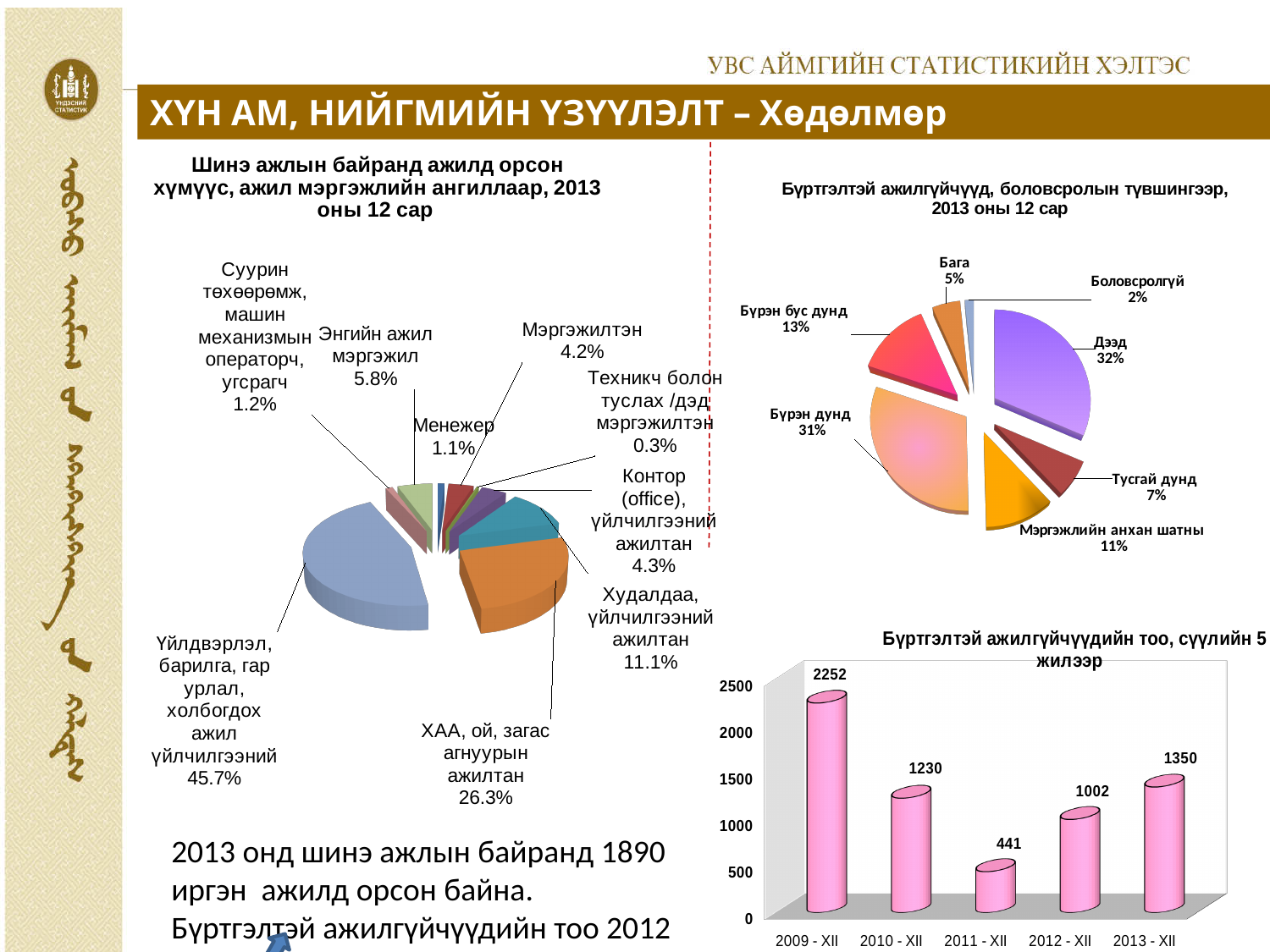
In the bar chart 'Бүртгэлтэй ажилгүйчүүдийн тоо, сүүлийн 5 жилээр', how many bars are shown? 5 In the pie chart 'Шинэ ажлын байранд ажилд орсон хүмүүс, ажил мэргэжлийн ангиллаар, 2013 оны 12 сар', what is the share for ХАА, ой, загас агнуурын ажилтан? 26.3% In the bar chart 'Бүртгэлтэй ажилгүйчүүдийн тоо, сүүлийн 5 жилээр', what is the difference between the values for 2013 - XII and 2012 - XII? 348 In the pie chart 'Шинэ ажлын байранд ажилд орсон хүмүүс, ажил мэргэжлийн ангиллаар, 2013 оны 12 сар', which category has the largest share? Үйлдвэрлэл, барилга, гар урлал, холбогдох ажил үйлчилгээний In the pie chart 'Бүртгэлтэй ажилгүйчүүд, боловсролын түвшингээр, 2013 оны 12 сар', what is the share for Дээд? 32% In the bar chart 'Бүртгэлтэй ажилгүйчүүдийн тоо, сүүлийн 5 жилээр', which year has the highest value? 2009 - XII In the pie chart 'Шинэ ажлын байранд ажилд орсон хүмүүс, ажил мэргэжлийн ангиллаар, 2013 оны 12 сар', which is larger: Мэргэжилтэн or Энгийн ажил мэргэжил? Энгийн ажил мэргэжил In the bar chart 'Бүртгэлтэй ажилгүйчүүдийн тоо, сүүлийн 5 жилээр', what is the value for 2011 - XII? 441 In the pie chart 'Бүртгэлтэй ажилгүйчүүд, боловсролын түвшингээр, 2013 оны 12 сар', how many categories are shown? 7 In the bar chart 'Бүртгэлтэй ажилгүйчүүдийн тоо, сүүлийн 5 жилээр', which year has the lowest value? 2011 - XII In the pie chart 'Бүртгэлтэй ажилгүйчүүд, боловсролын түвшингээр, 2013 оны 12 сар', which category has the smallest share? Боловсролгүй What kind of chart is 'Бүртгэлтэй ажилгүйчүүдийн тоо, сүүлийн 5 жилээр'? Bar chart